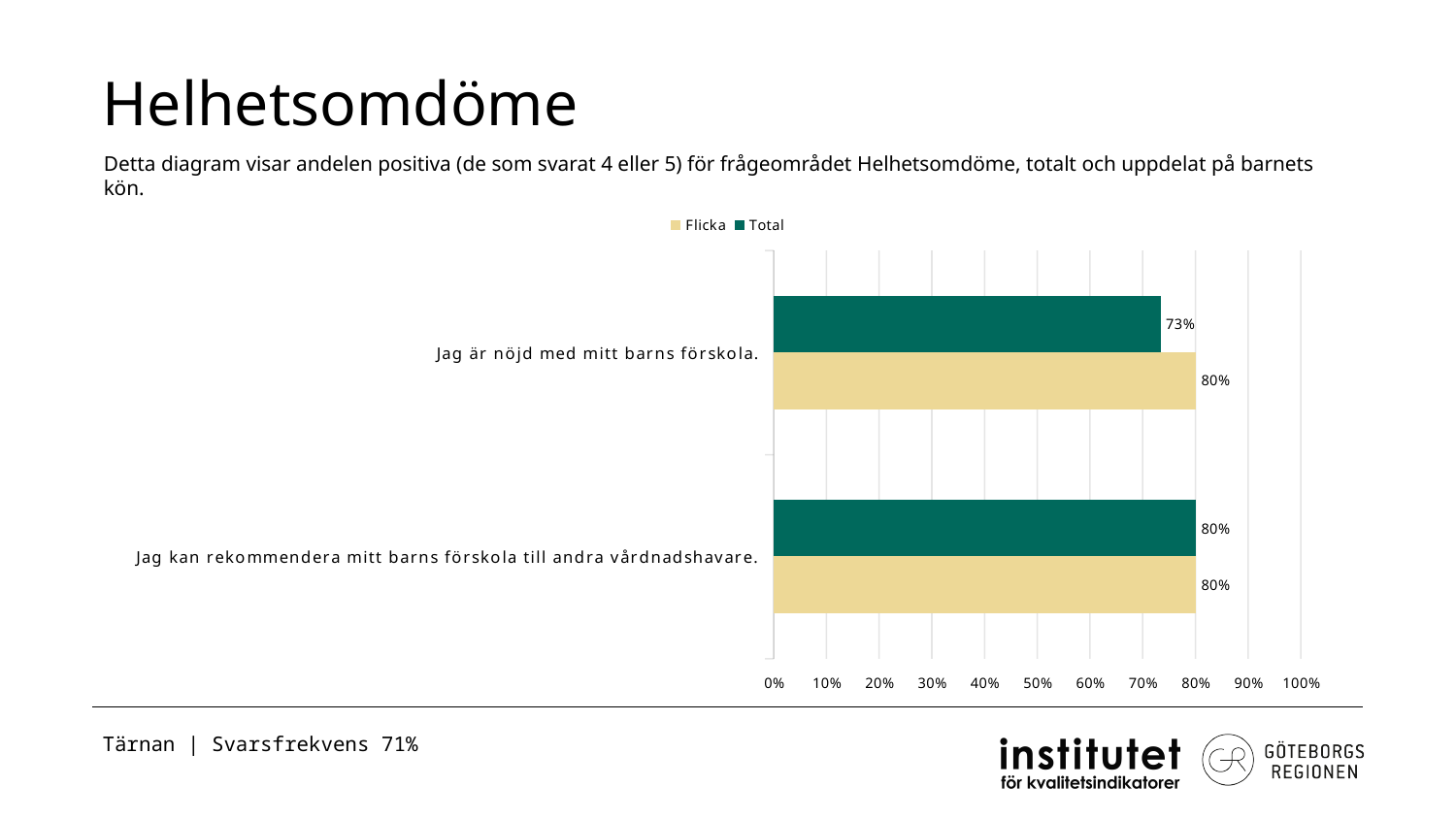
How many series does the legend list? 2 Which category has the lowest Total value? Jag är nöjd med mitt barns förskola. Is the Total value for "Jag är nöjd med mitt barns förskola." greater or less than 70%? greater What kind of chart is shown on the slide? Bar chart How many categories are shown in the chart? 2 What is the difference between the Flicka and Total values for "Jag är nöjd med mitt barns förskola."? 7 percentage points What is the Flicka value for "Jag kan rekommendera mitt barns förskola till andra vårdnadshavare."? 80% For "Jag är nöjd med mitt barns förskola.", which is larger, the Flicka value or the Total value? Flicka What is the Flicka value for "Jag är nöjd med mitt barns förskola."? 80% What is the Total value for "Jag är nöjd med mitt barns förskola."? 73% Which series is shown in green in the chart? Total What is the Total value for "Jag kan rekommendera mitt barns förskola till andra vårdnadshavare."? 80%